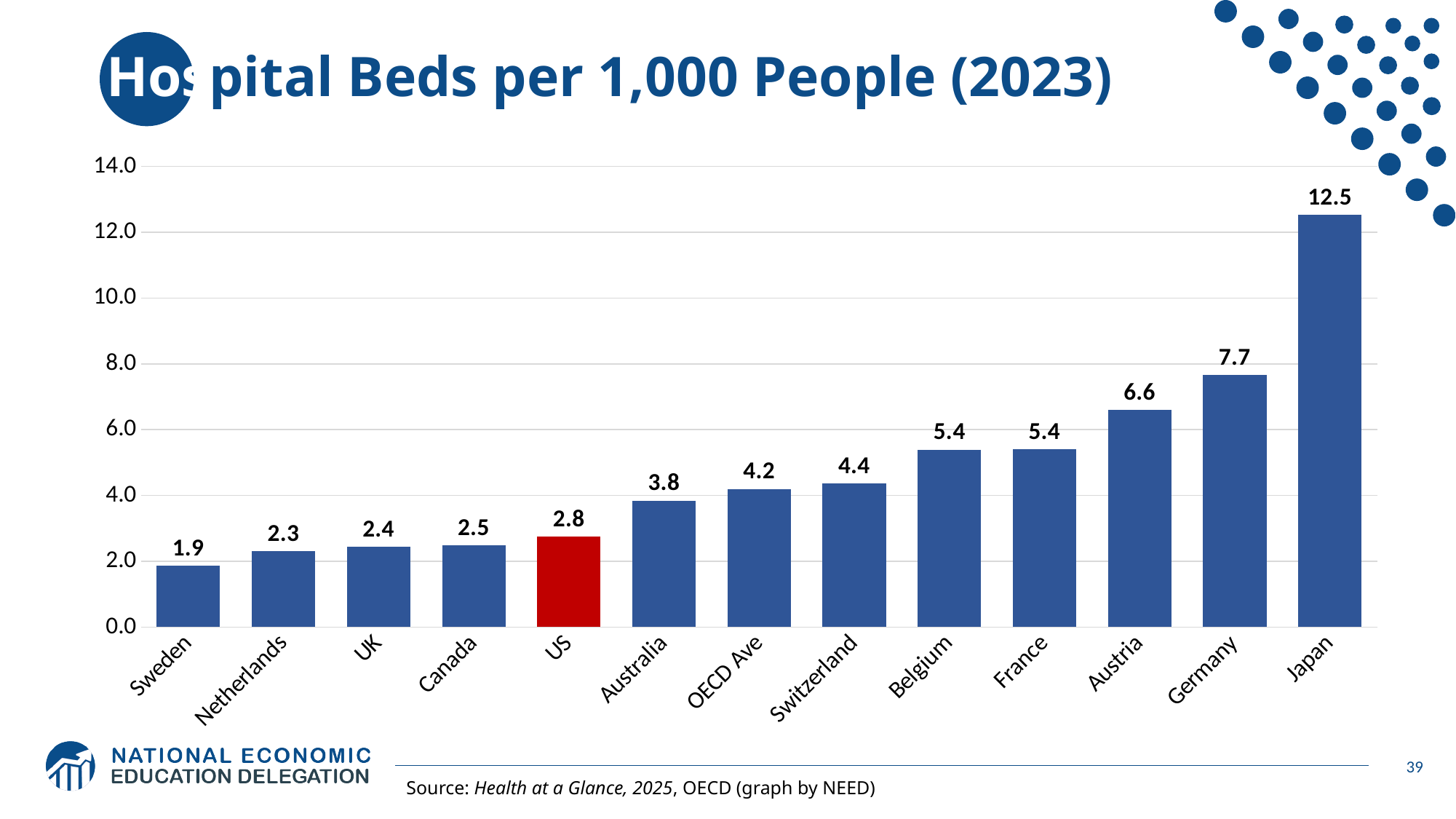
Which category has the highest value? Japan Which is larger, the value for Australia or the value for Canada? Australia What is the value for the US? 2.8 What is the difference between the values for Germany and the US? 4.9 Which bar is coloured red? US Which category has the lowest value? Sweden Is the value for Austria greater or less than 6.0? greater What kind of chart is this? bar chart What is the value for Japan? 12.5 What is the value for the OECD Ave? 4.2 What is the difference between the values for the OECD Ave and the US? 1.4 How many categories are shown on the x axis? 13